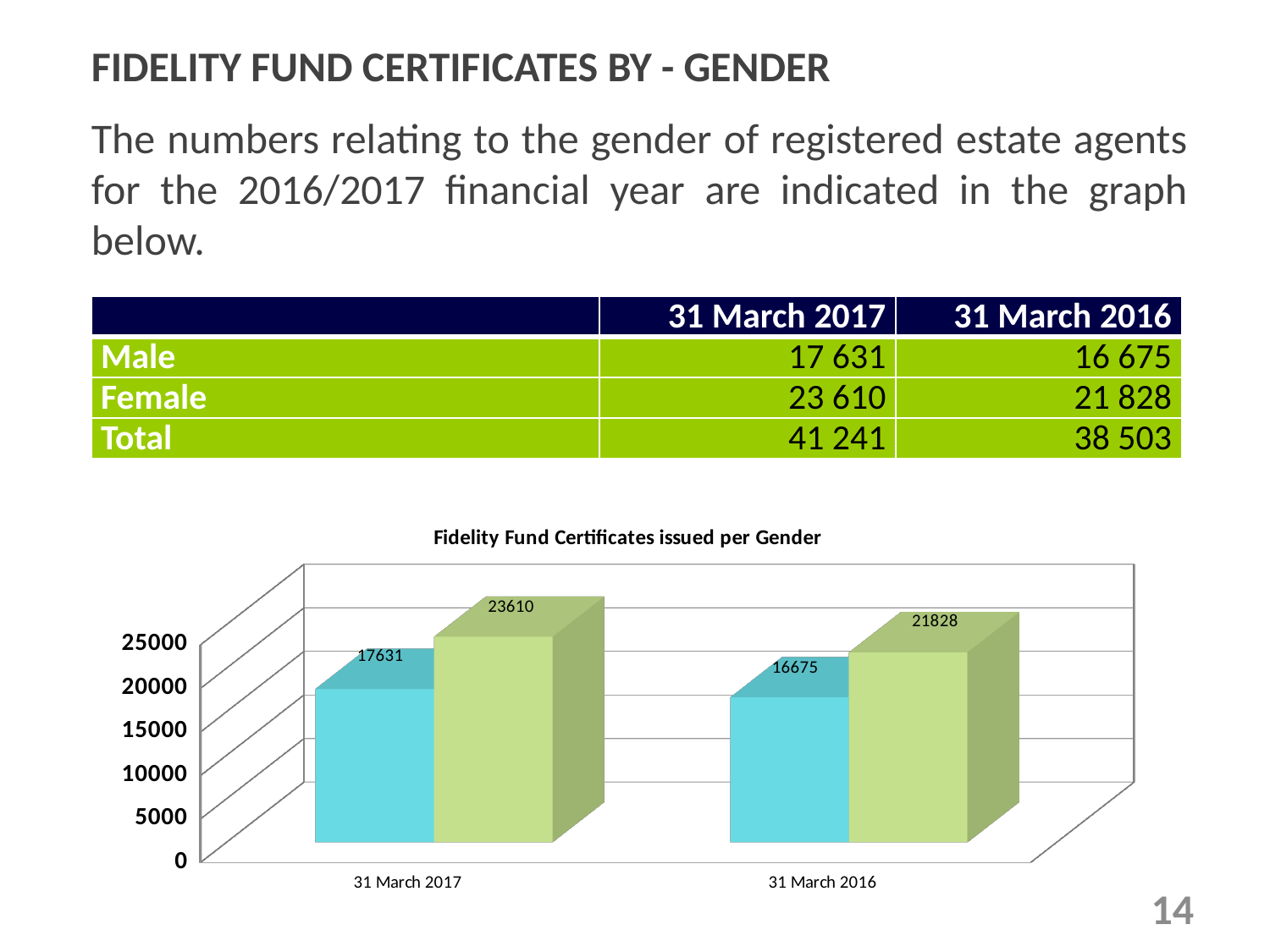
In the chart, what is the value of the green bar for 31 March 2016? 21828 What is the difference between the two bars for 31 March 2017 in the chart? 5979 How many categories are shown on the x axis of the chart? 2 In the chart, is the green bar for 31 March 2017 larger or smaller than the green bar for 31 March 2016? larger What kind of chart is shown on the slide? bar chart What is the title of the chart on the slide? Fidelity Fund Certificates issued per Gender Which bar in the chart has the lowest value? the blue bar for 31 March 2016 (16675) In the chart, what is the value of the shorter (blue) bar for 31 March 2016? 16675 Which bar in the chart has the highest value? the green bar for 31 March 2017 (23610) Is the value of the blue bar for 31 March 2016 greater or less than 20000? less In the chart, what is the value of the blue bar for 31 March 2017? 17631 In the chart, what is the value of the taller (green) bar for 31 March 2017? 23610